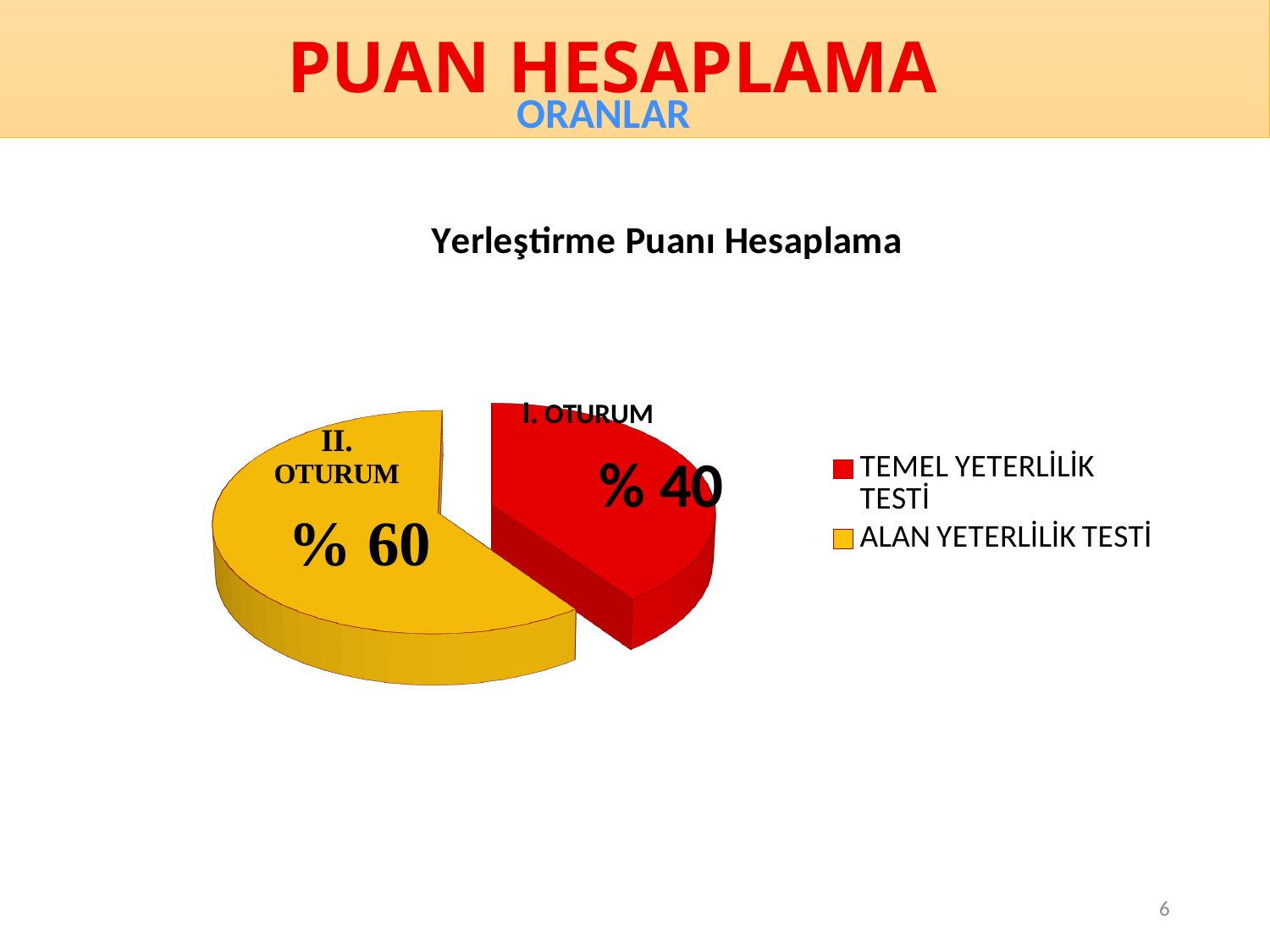
Which slice is the largest? II. OTURUM What share of the pie does the ALAN YETERLİLİK TESTİ slice represent? % 60 What is the difference between the II. OTURUM and I. OTURUM values? % 20 What kind of chart is shown on the slide? pie chart What is the chart's title? Yerleştirme Puanı Hesaplama Which is larger, the I. OTURUM slice or the II. OTURUM slice? II. OTURUM Which slice is the smallest? I. OTURUM How many entries does the legend list? 2 Which legend entry corresponds to the red slice? TEMEL YETERLİLİK TESTİ How many slices does the pie chart have? 2 What value is shown for the I. OTURUM slice? % 40 What value is shown for the II. OTURUM slice? % 60